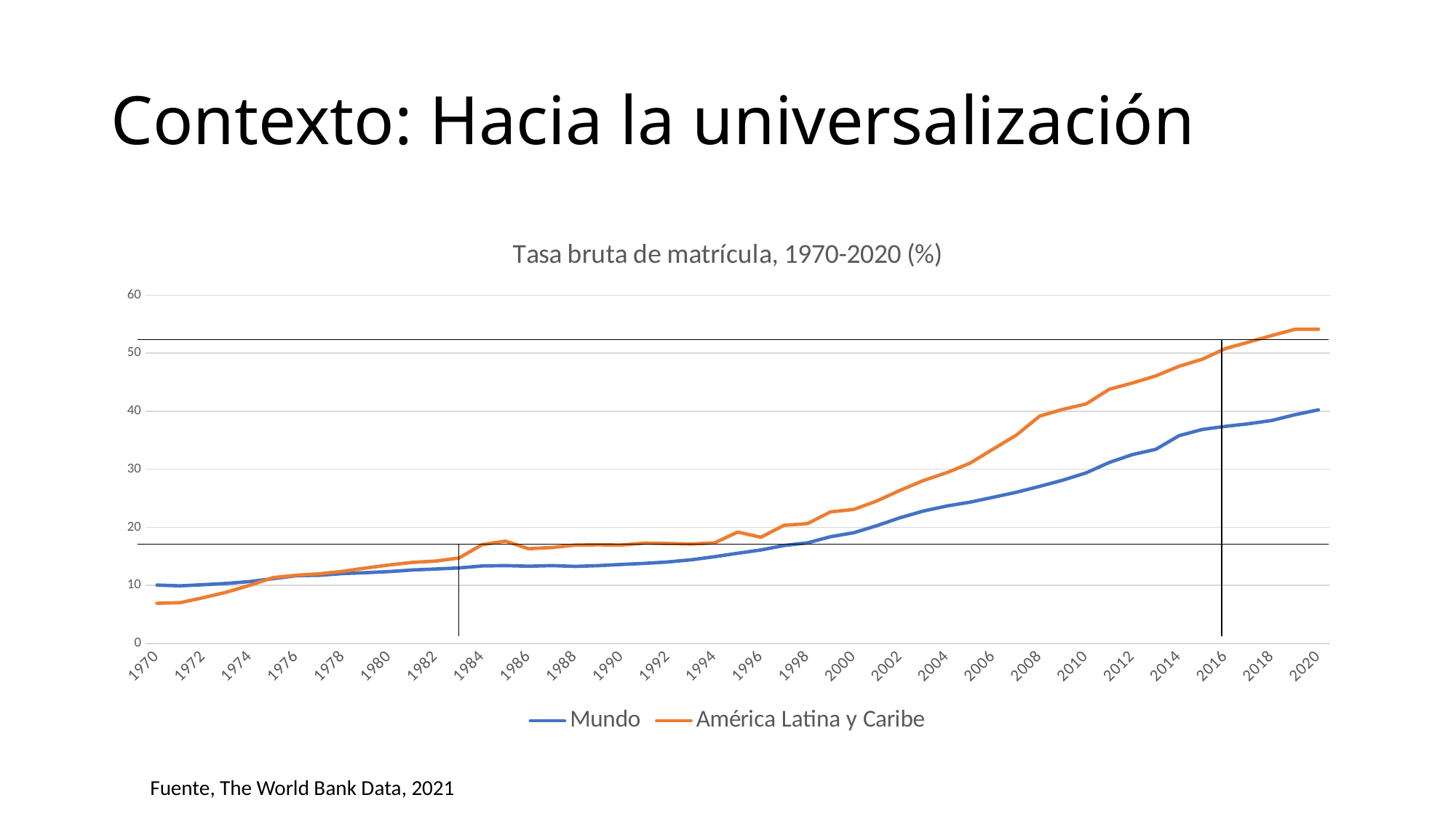
How many series does the legend list? 2 Is the value for Mundo in 1970 greater or less than 20? less Is the value for Mundo in 2020 greater or less than 30? greater What kind of chart is shown on the slide? line chart Do the values for Mundo rise or fall from 1970 to 2020? rise Do the values for América Latina y Caribe rise or fall from 1970 to 2020? rise Which series is drawn in orange? América Latina y Caribe What is the title of the chart? Tasa bruta de matrícula, 1970-2020 (%) In 2020, which series has the higher value, Mundo or América Latina y Caribe? América Latina y Caribe In 1970, which series has the higher value, Mundo or América Latina y Caribe? Mundo Is the value for América Latina y Caribe in 2020 greater or less than 50? greater